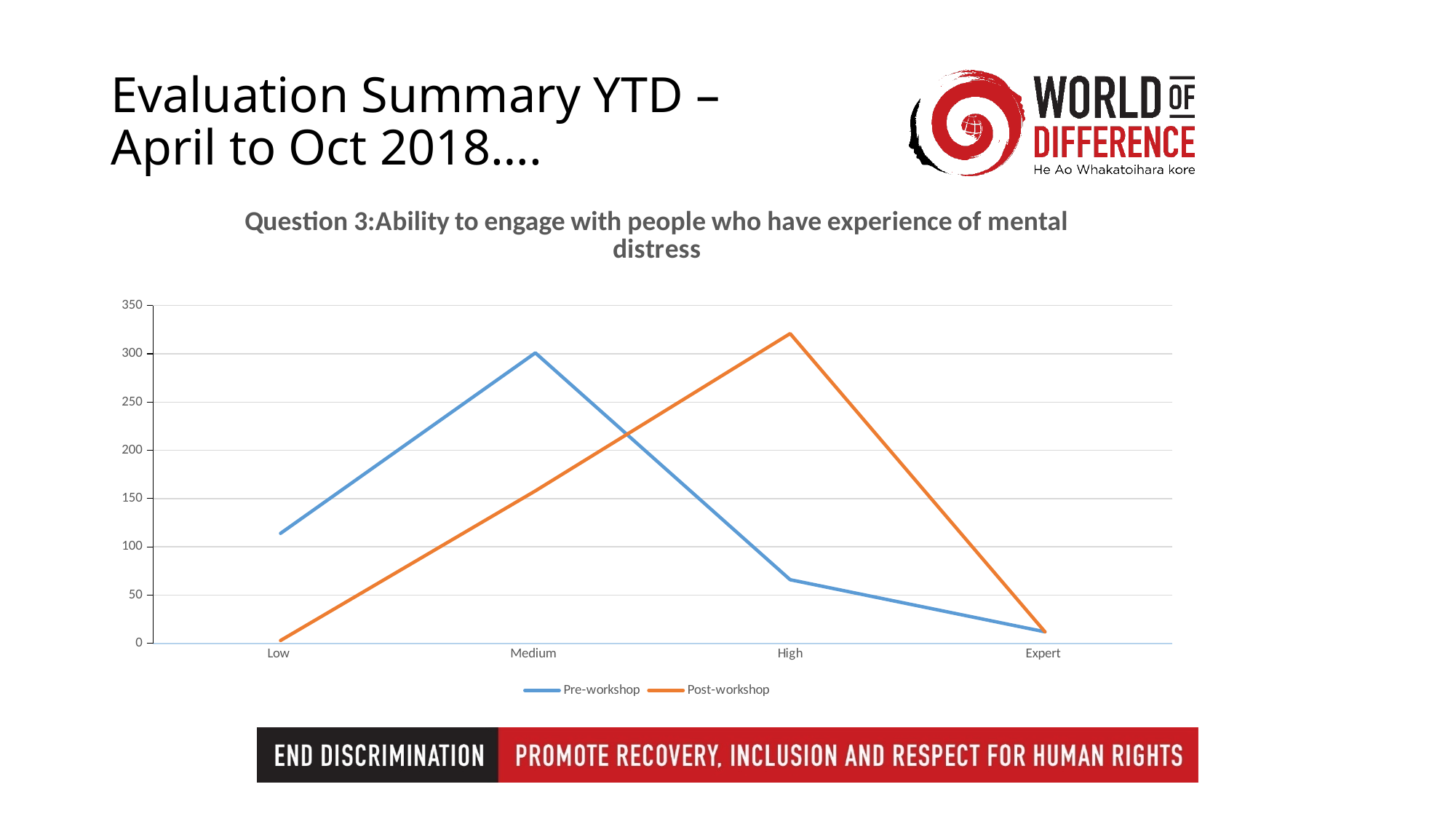
For which category is the Pre-workshop series highest? Medium At the High category, which series has the larger value, Pre-workshop or Post-workshop? Post-workshop Is the Pre-workshop value for High greater or less than 100? less Does the Post-workshop series rise or fall from Low to High? rise How many series does the legend list? 2 For which category is the Post-workshop series lowest? Low Is the Pre-workshop value for Low greater or less than 100? greater At the Low category, which series has the larger value, Pre-workshop or Post-workshop? Pre-workshop For which category is the Post-workshop series highest? High What kind of chart is shown on the slide? line chart Is the Post-workshop value for High greater or less than 300? greater How many categories are shown on the x axis? 4